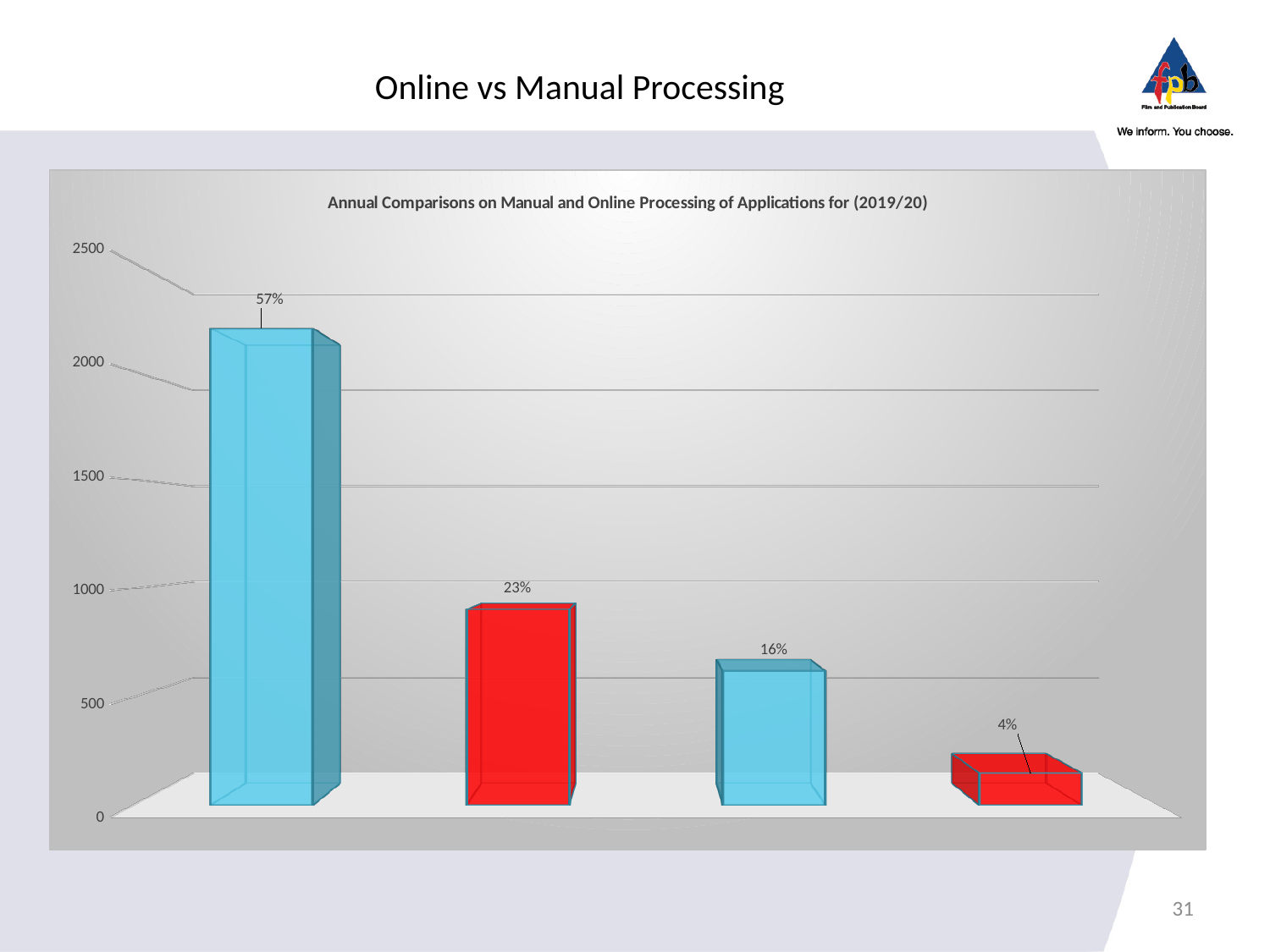
Is the value of the second bar from the left greater or less than 1000 on the axis? less Which bar has the lowest value? the rightmost (fourth) bar, 4% Which bar has the highest value? the leftmost (first) bar, 57% What kind of chart is shown on the slide? bar chart What percentage label is shown on the second bar from the left? 23% What is the difference between the percentage labels of the first and second bars? 34% What percentage label is shown on the rightmost (fourth) bar? 4% What percentage label is shown on the third bar from the left? 16% What percentage label is shown on the leftmost (first) bar? 57% What is the title of the chart? Annual Comparisons on Manual and Online Processing of Applications for (2019/20) Is the value of the leftmost bar greater or less than 2000 on the axis? greater How many bars are plotted in the chart? 4